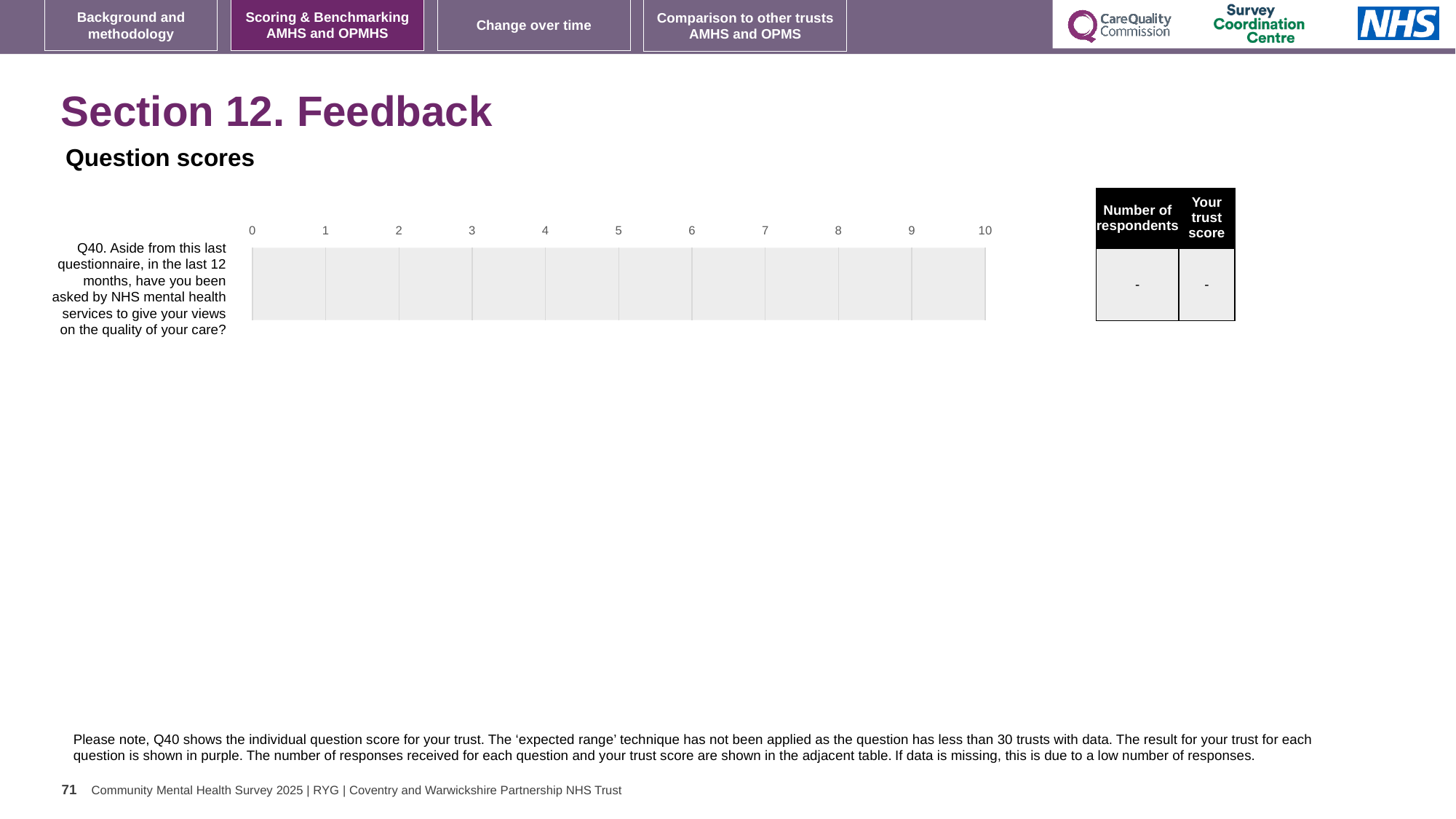
What is shown in the 'Your trust score' column of the table for Q40? - Is a bar plotted for Q40 on the chart? No What is the lowest value shown on the chart's x axis? 0 How many questions (categories) are plotted on the chart? 1 Which question number is shown as the category on the chart? Q40 What kind of chart is shown on the slide? bar chart What is shown in the 'Number of respondents' column of the table for Q40? - What is the highest value shown on the chart's x axis? 10